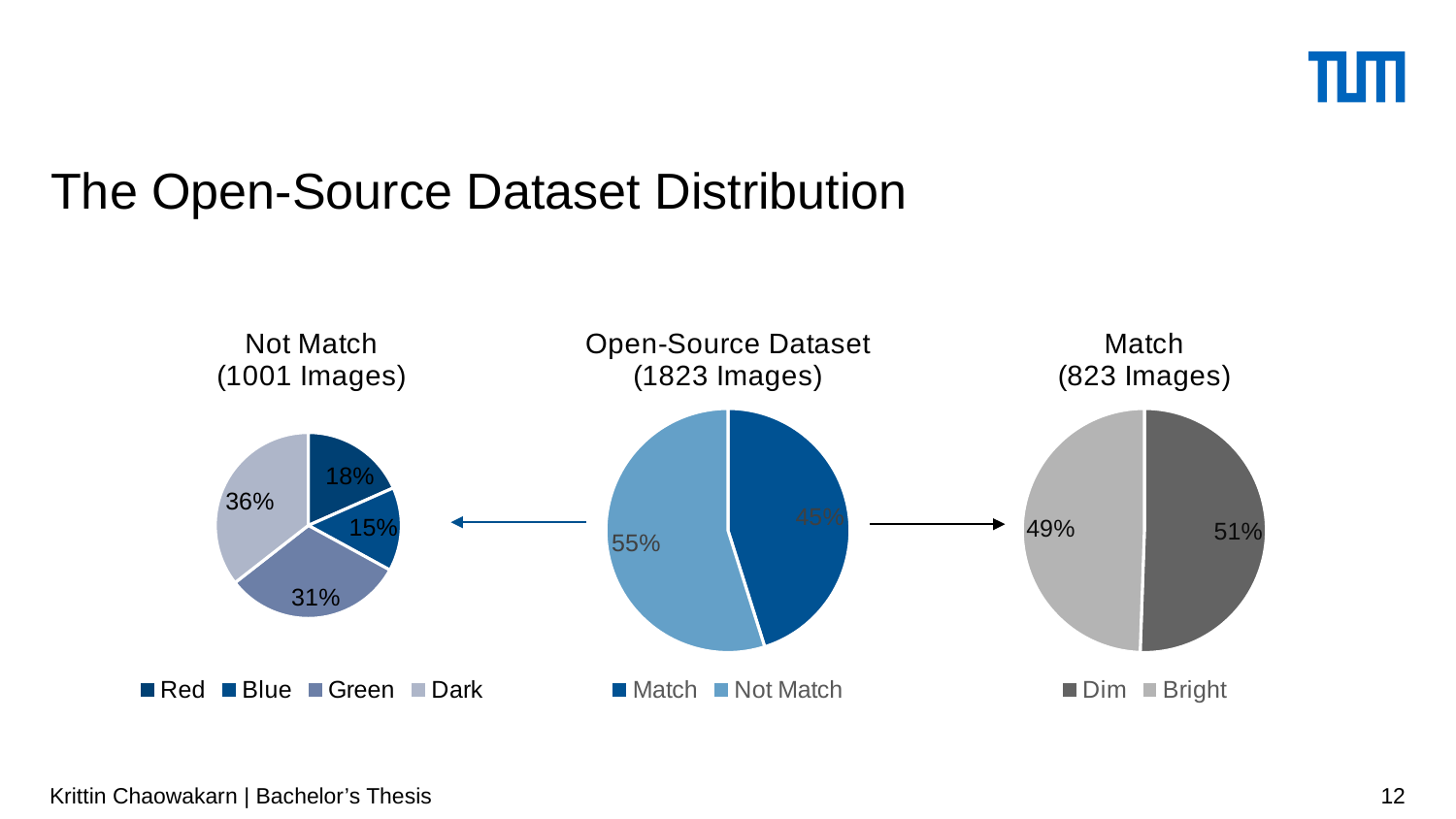
In the Not Match (1001 Images) pie chart, which category has the largest share? Dark In the Not Match (1001 Images) pie chart, what share is Dark? 36% In the Open-Source Dataset (1823 Images) pie chart, which is larger, Match or Not Match? Not Match In the Not Match (1001 Images) pie chart, what share is Green? 31% What kind of chart is the Match (823 Images) chart? Pie chart In the Open-Source Dataset (1823 Images) pie chart, what share is Not Match? 55% In the Not Match (1001 Images) pie chart, which category has the smallest share? Blue How many categories does the legend of the Not Match (1001 Images) chart list? 4 In the Match (823 Images) pie chart, what is the difference between the Dim and Bright shares? 2% In the Not Match (1001 Images) pie chart, what is the difference between the Dark and Red shares? 18%